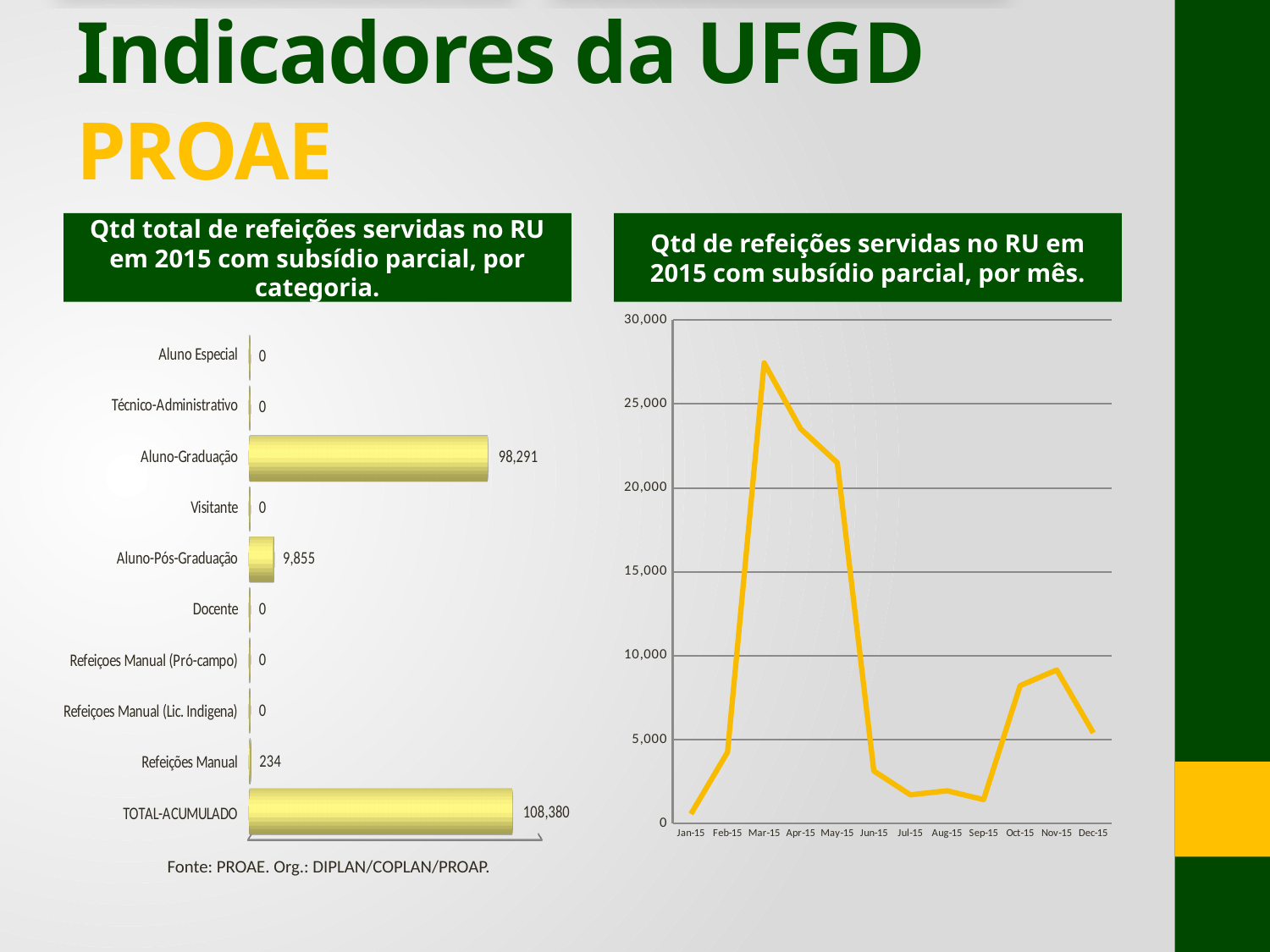
In the bar chart on the left, what is the difference between Aluno-Graduação and Aluno-Pós-Graduação? 88,436 In the line chart on the right, is the value for Mar-15 greater or less than 25,000? greater In the line chart on the right, do the values rise or fall from Mar-15 to Sep-15? fall In the line chart on the right, which month has the highest value? Mar-15 What kind of chart is the chart on the left? bar chart In the bar chart on the left, how many categories are shown? 10 In the bar chart on the left, what is the value for Aluno-Graduação? 98,291 In the bar chart on the left, what is the value for Aluno-Pós-Graduação? 9,855 In the bar chart on the left, what is the value for Refeições Manual? 234 What kind of chart is the chart on the right? line chart In the bar chart on the left, what is the value for TOTAL-ACUMULADO? 108,380 In the bar chart on the left, which is larger, Aluno-Pós-Graduação or Refeições Manual? Aluno-Pós-Graduação